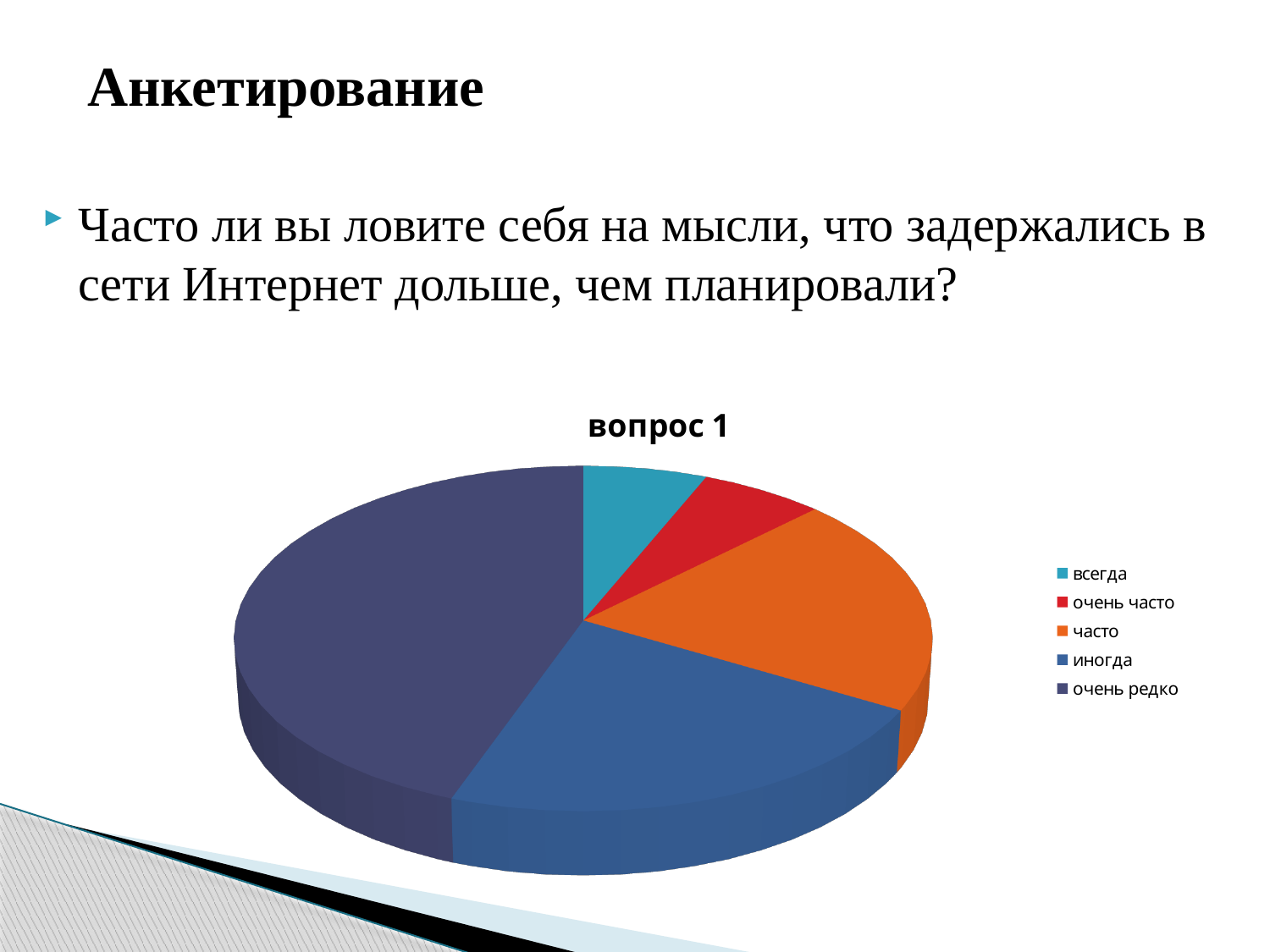
How many slices does the pie chart have? 5 Which slice is larger, "часто" or "очень часто"? часто Which category has the largest slice in the pie chart? очень редко Which category is shown in orange in the pie chart? часто What is the title of the chart? вопрос 1 What kind of chart is shown on the slide? pie chart Which slice is larger, "иногда" or "часто"? иногда Which slice is larger, "очень редко" or "иногда"? очень редко How many categories does the legend of the chart list? 5